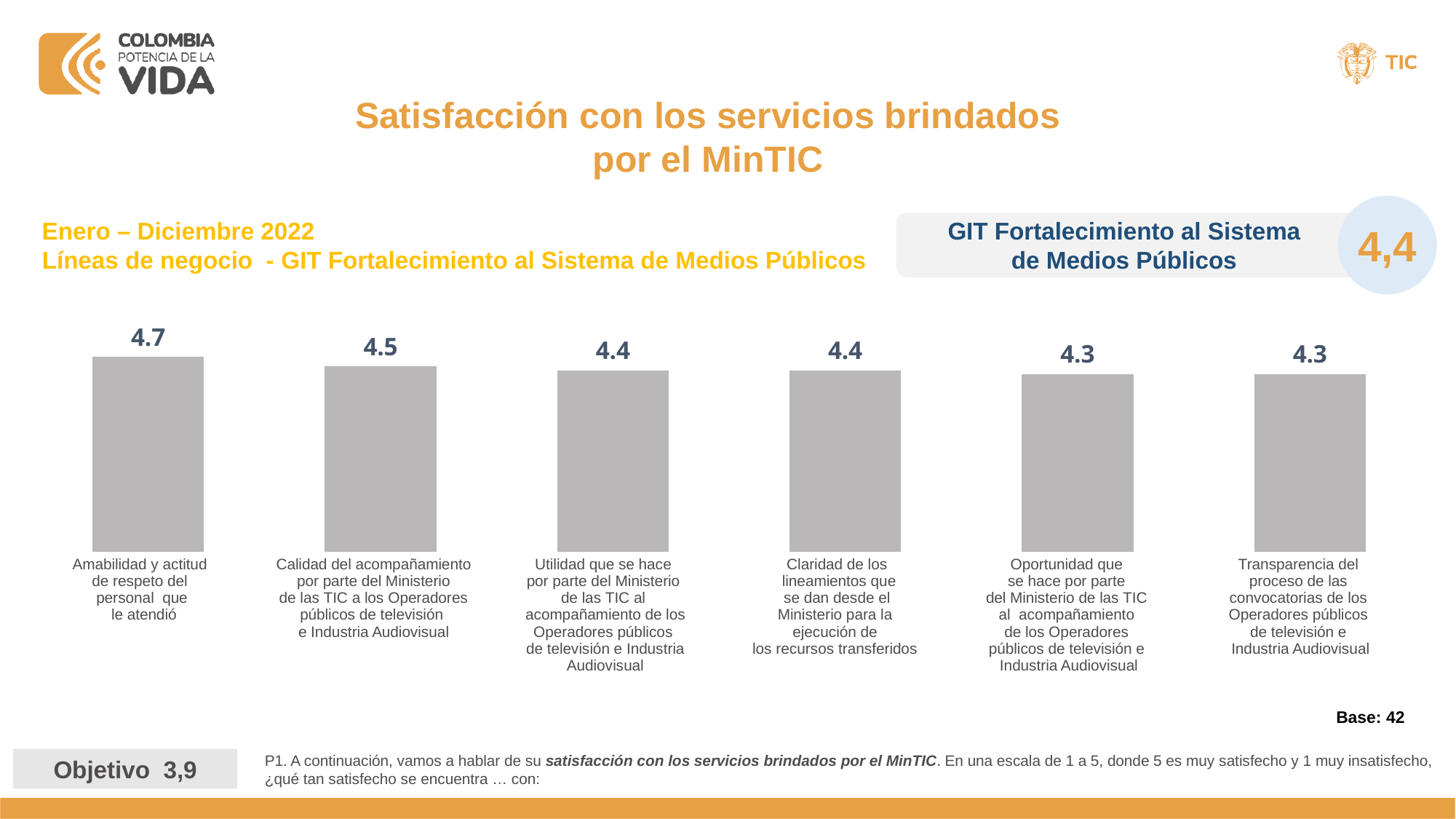
Which is larger: the score for 'Calidad del acompañamiento' or the score for 'Oportunidad que se hace por parte del Ministerio de las TIC al acompañamiento'? Calidad del acompañamiento What is the base (number of respondents) shown on the slide? 42 What is the satisfaction score for 'Amabilidad y actitud de respeto del personal que le atendió'? 4.7 What is the satisfaction score for 'Claridad de los lineamientos que se dan desde el Ministerio para la ejecución de los recursos transferidos'? 4.4 What is the difference between the score for 'Amabilidad y actitud de respeto del personal que le atendió' and the score for 'Transparencia del proceso de las convocatorias'? 0.4 What is the satisfaction score for 'Transparencia del proceso de las convocatorias de los Operadores públicos de televisión e Industria Audiovisual'? 4.3 What is the overall score shown for GIT Fortalecimiento al Sistema de Medios Públicos? 4,4 What is the satisfaction score for 'Calidad del acompañamiento por parte del Ministerio de las TIC a los Operadores públicos de televisión e Industria Audiovisual'? 4.5 What kind of chart is shown on the slide? Bar chart Do the scores rise or fall from left to right across the chart? Fall How many categories are shown in the bar chart? 6 Which category has the highest satisfaction score? Amabilidad y actitud de respeto del personal que le atendió